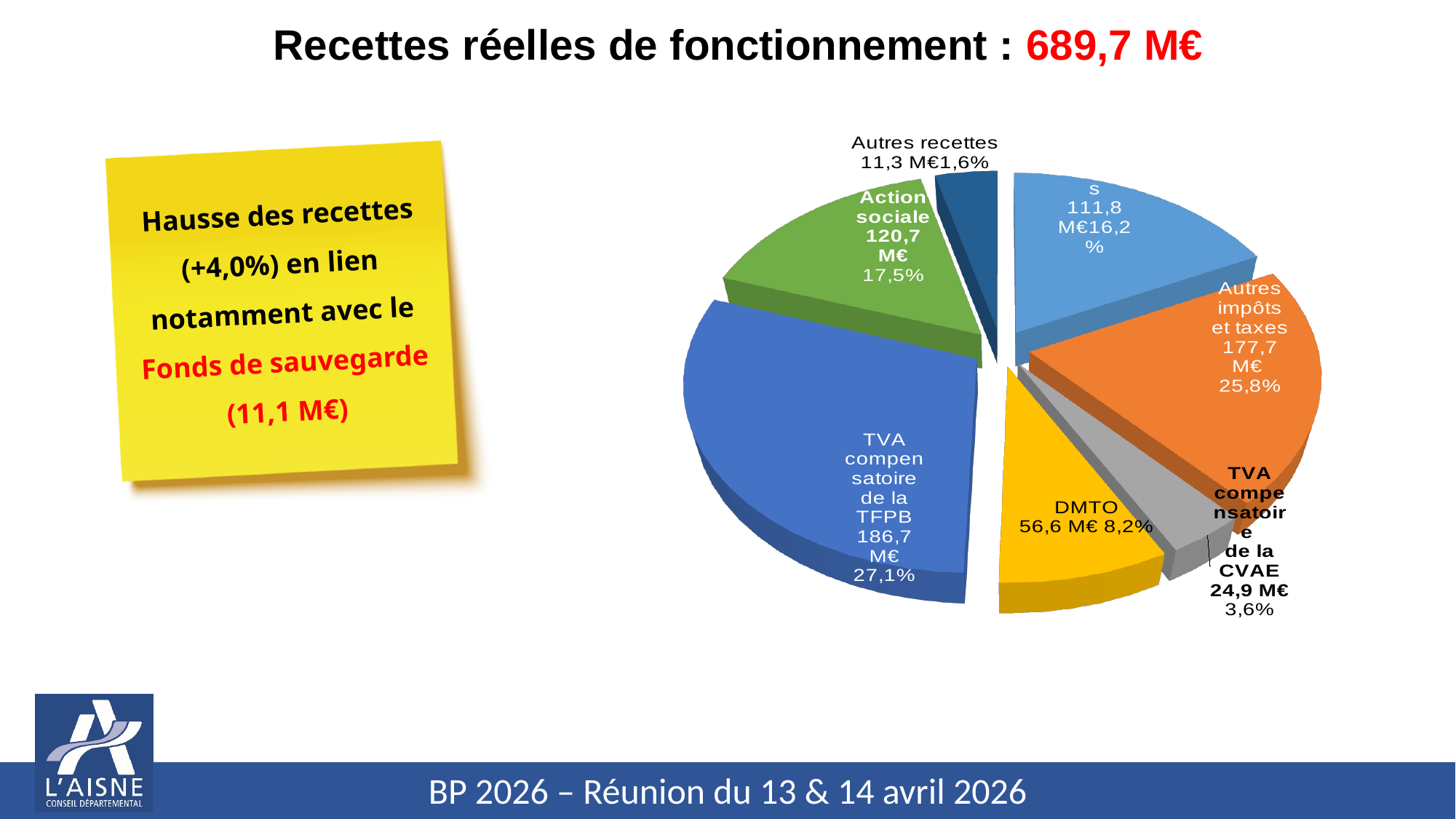
What is the value shown for Action sociale? 120,7 M€ What is the difference between TVA compensatoire de la TFPB and Autres impôts et taxes? 9,0 M€ What is the value shown for TVA compensatoire de la CVAE? 24,9 M€ How many slices does the pie chart have? 7 Which slice of the pie chart is the largest? TVA compensatoire de la TFPB What is the value shown for DMTO? 56,6 M€ What kind of chart is shown on the slide? Pie chart What is the value shown for Autres impôts et taxes? 177,7 M€ What share of the pie does Action sociale represent? 17,5% Which slice of the pie chart is the smallest? Autres recettes What share of the pie does Autres recettes represent? 1,6% Which is larger, Action sociale or DMTO? Action sociale